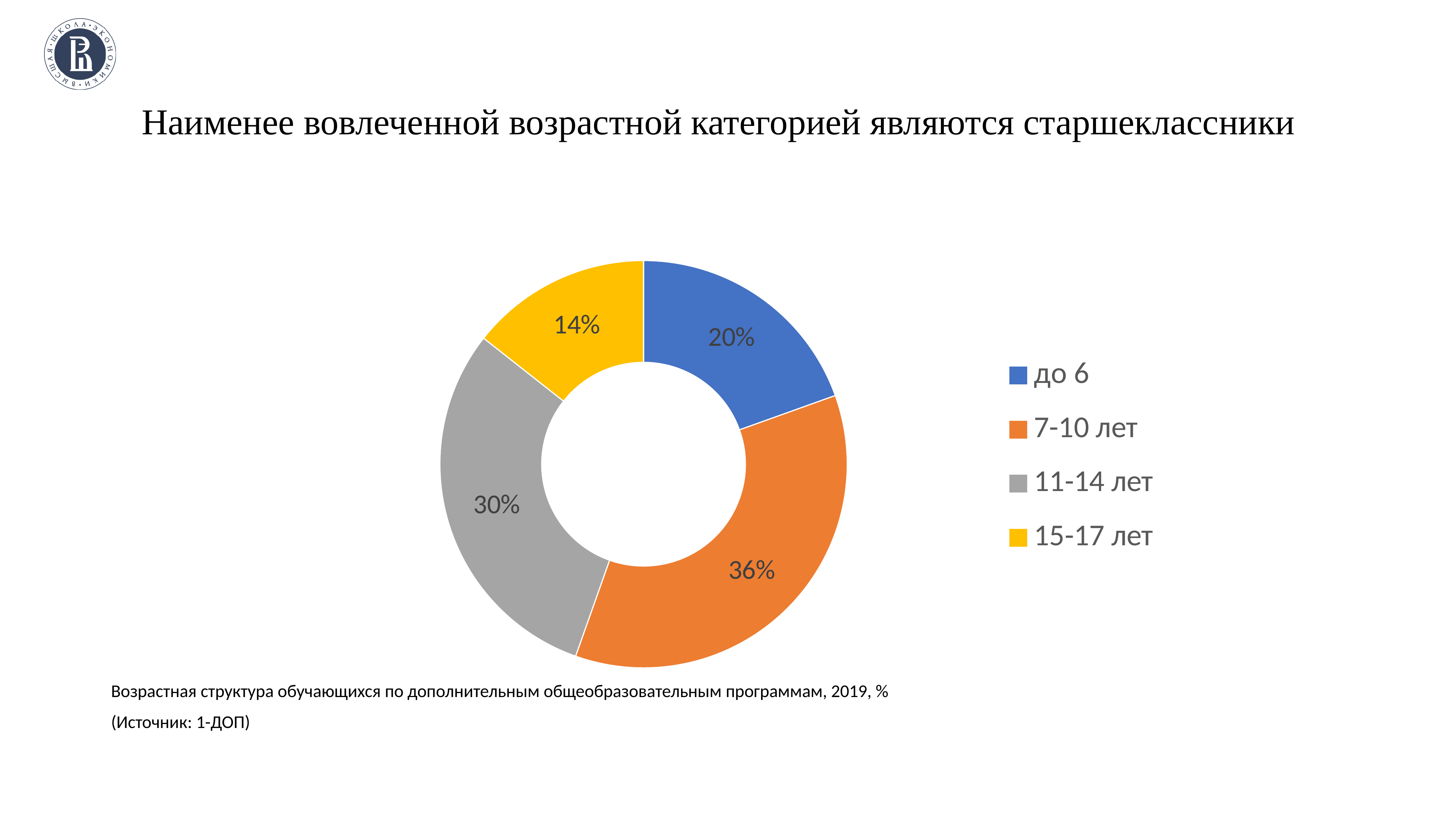
What share of the chart does the "до 6" category have? 20% What is the difference in percentage points between the "7-10 лет" and "15-17 лет" shares? 22 What share of the chart does the "7-10 лет" category have? 36% What share of the chart does the "11-14 лет" category have? 30% What share of the chart does the "15-17 лет" category have? 14% Which age category has the largest share? 7-10 лет What colour represents the "15-17 лет" category? Yellow Which is larger, the share for "11-14 лет" or the share for "до 6"? 11-14 лет How many categories does the chart show? 4 Which age category has the smallest share? 15-17 лет What is the source cited for the chart data? 1-ДОП What kind of chart is shown on the slide? Doughnut (pie) chart